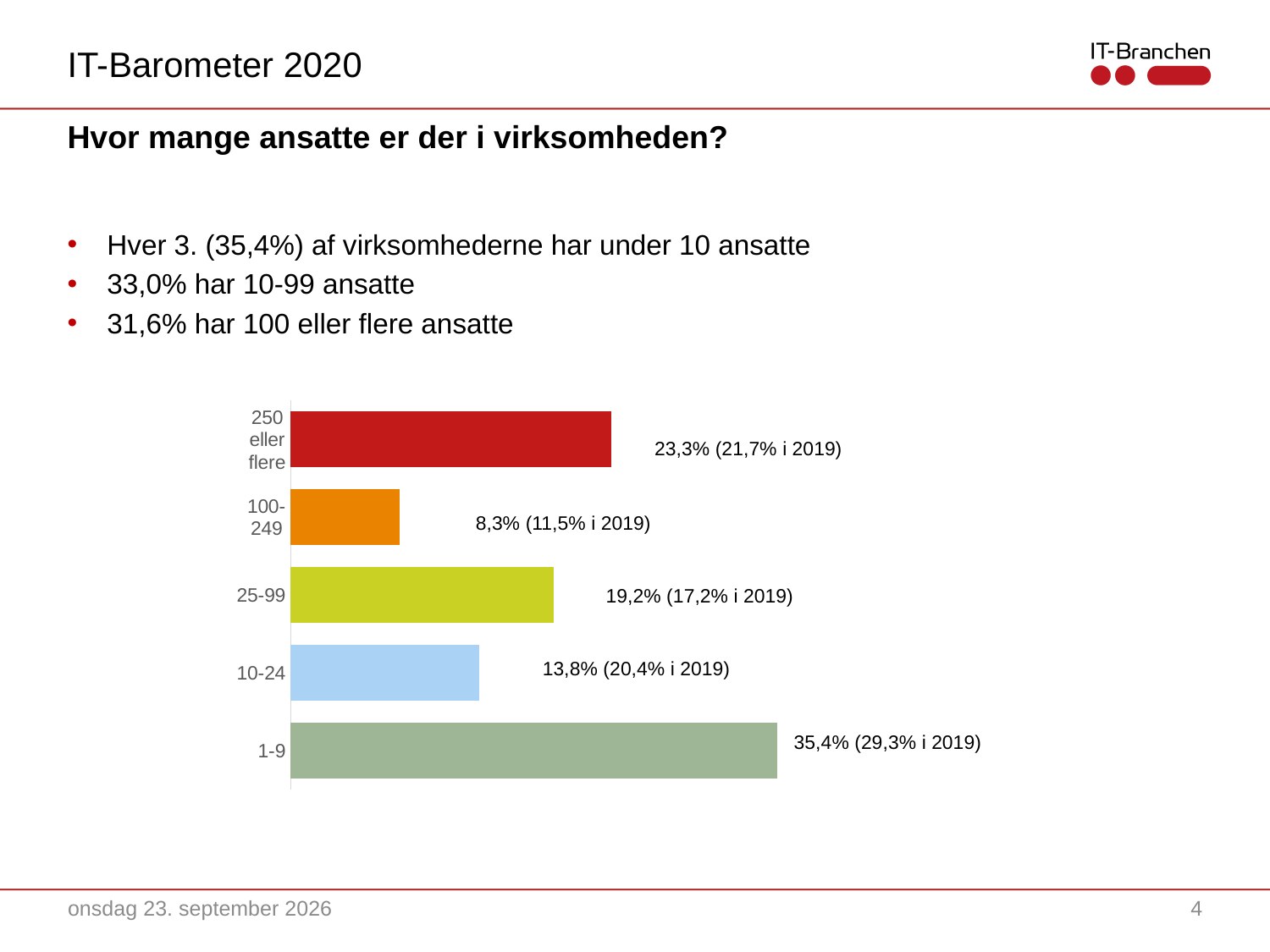
What is the difference between the values for 25-99 and 10-24? 5,4 percentage points How many categories are shown in the chart? 5 Which category has the highest value? 1-9 What is the value shown for the 1-9 category? 35,4% Which category has the lowest value? 100-249 What kind of chart is shown on the slide? Bar chart What is the difference between the values for 1-9 and 250 eller flere? 12,1 percentage points What colour is the bar for the 250 eller flere category? Red What was the 2019 value shown for the 10-24 category? 20,4% What was the 2019 value shown for the 250 eller flere category? 21,7% What is the value shown for the 100-249 category? 8,3% Which is larger, the value for 25-99 or the value for 10-24? 25-99